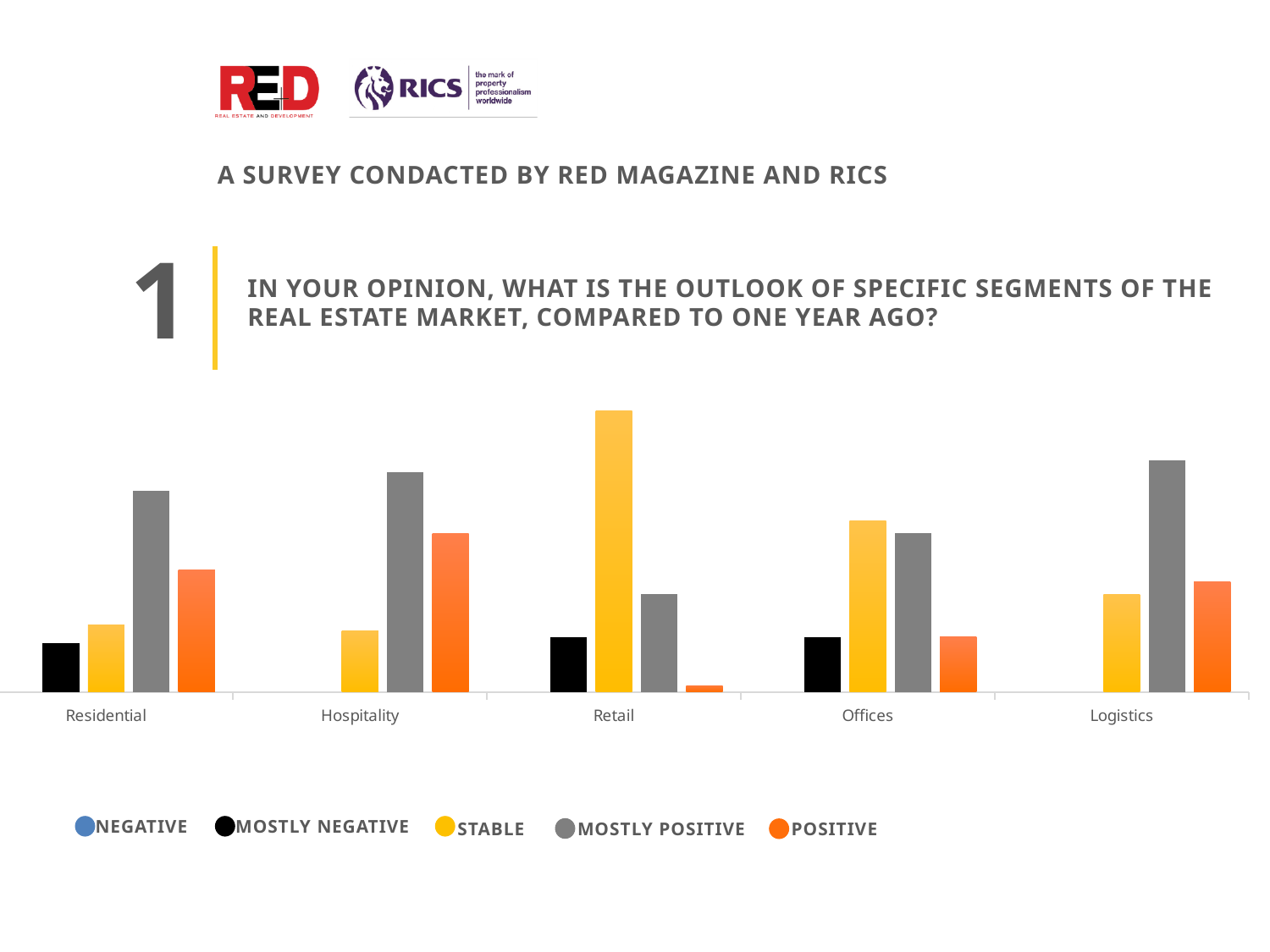
Which legend entry has no bars plotted in the chart? Negative How many categories show a Mostly Negative bar? 3 For Offices, which is larger: Stable or Positive? Stable How many series does the legend list? 5 Which category contains the tallest bar in the whole chart? Retail How many real estate segments (categories) are shown on the x axis? 5 For Hospitality, which is larger: Mostly Positive or Positive? Mostly Positive What kind of chart is shown on the slide? Bar chart For Retail, which response has the tallest bar? Stable For Retail, which of the plotted responses has the shortest bar? Positive For Residential, which response has the tallest bar? Mostly Positive